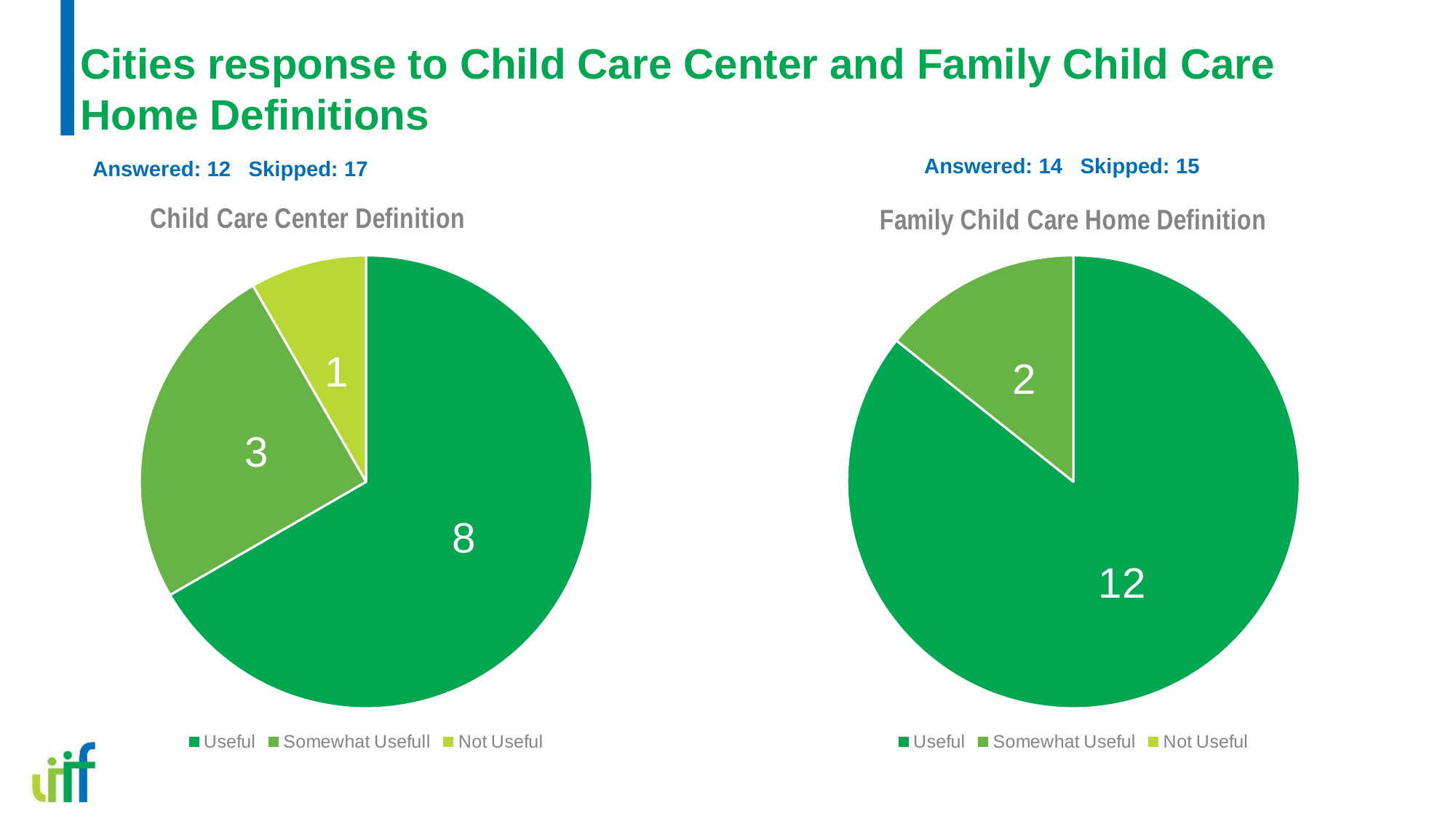
How many entries does the legend of the Family Child Care Home Definition chart list? 3 In the Family Child Care Home Definition chart, what is the difference between the Useful and Somewhat Useful values? 10 What type of chart is the Child Care Center Definition chart? Pie chart In the Child Care Center Definition chart, which category has the largest slice? Useful How many slices are shown in the Child Care Center Definition pie chart? 3 In the Child Care Center Definition chart, what is the value for Somewhat Usefull? 3 Which is larger: the Useful value in the Child Care Center Definition chart or the Useful value in the Family Child Care Home Definition chart? Family Child Care Home Definition In the Child Care Center Definition chart, what is the value for Not Useful? 1 In the Child Care Center Definition chart, which category has the smallest slice? Not Useful In the Family Child Care Home Definition chart, what is the value for Useful? 12 In the Child Care Center Definition chart, how many cities rated the definition Useful? 8 In the Family Child Care Home Definition chart, what is the value for Somewhat Useful? 2